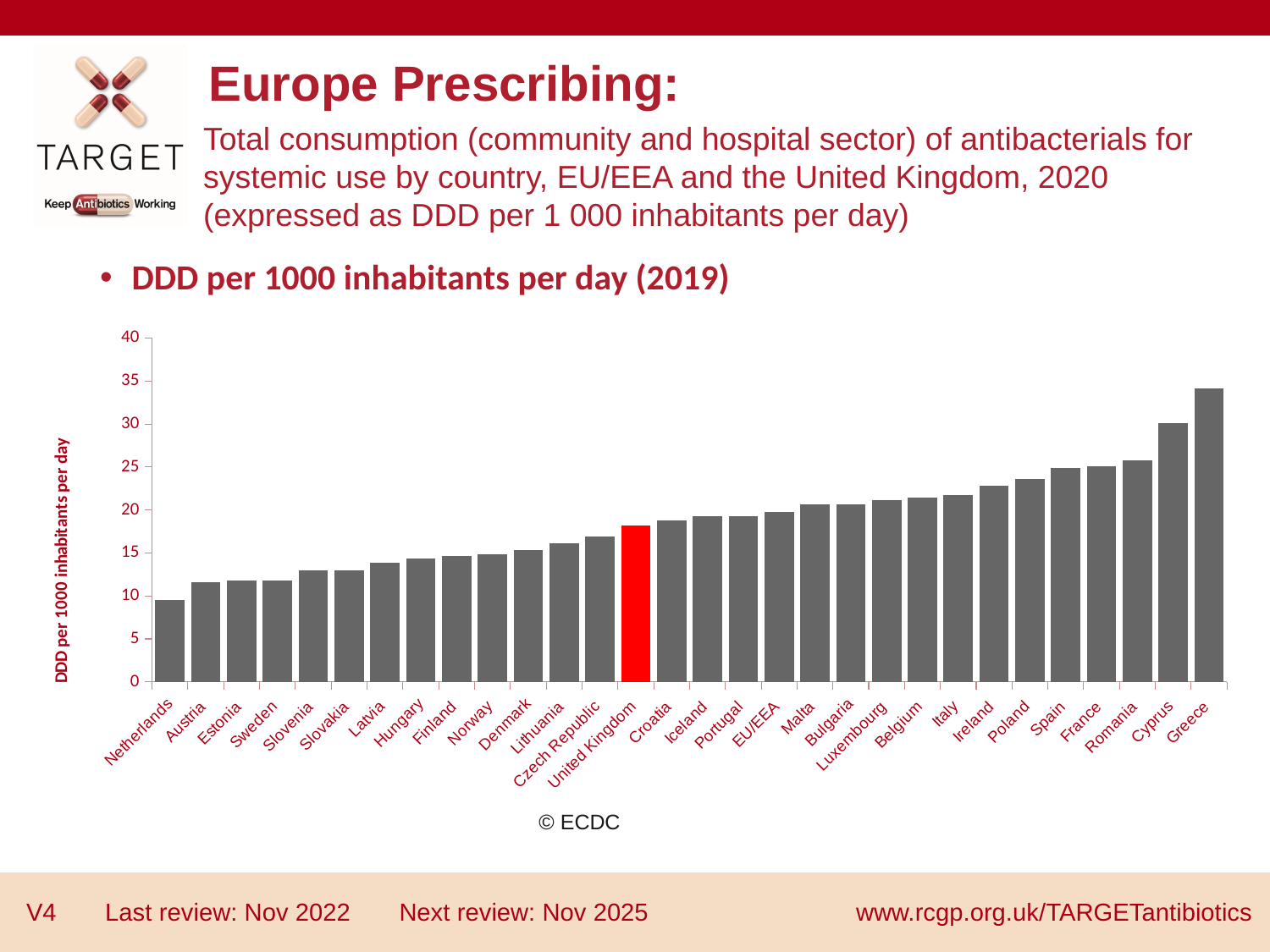
Which has the larger value, Greece or Cyprus? Greece Do the values rise or fall moving from left to right along the x axis? rise Is the value for Poland greater or less than 20? greater What kind of chart is shown on the slide? bar chart Which country has the lowest DDD per 1000 inhabitants per day? Netherlands Is the value for the United Kingdom greater or less than 15? greater Is the value for Greece greater or less than 30? greater Which country has the highest DDD per 1000 inhabitants per day? Greece Which bar is highlighted in red? United Kingdom How many countries/regions are plotted on the x axis? 30